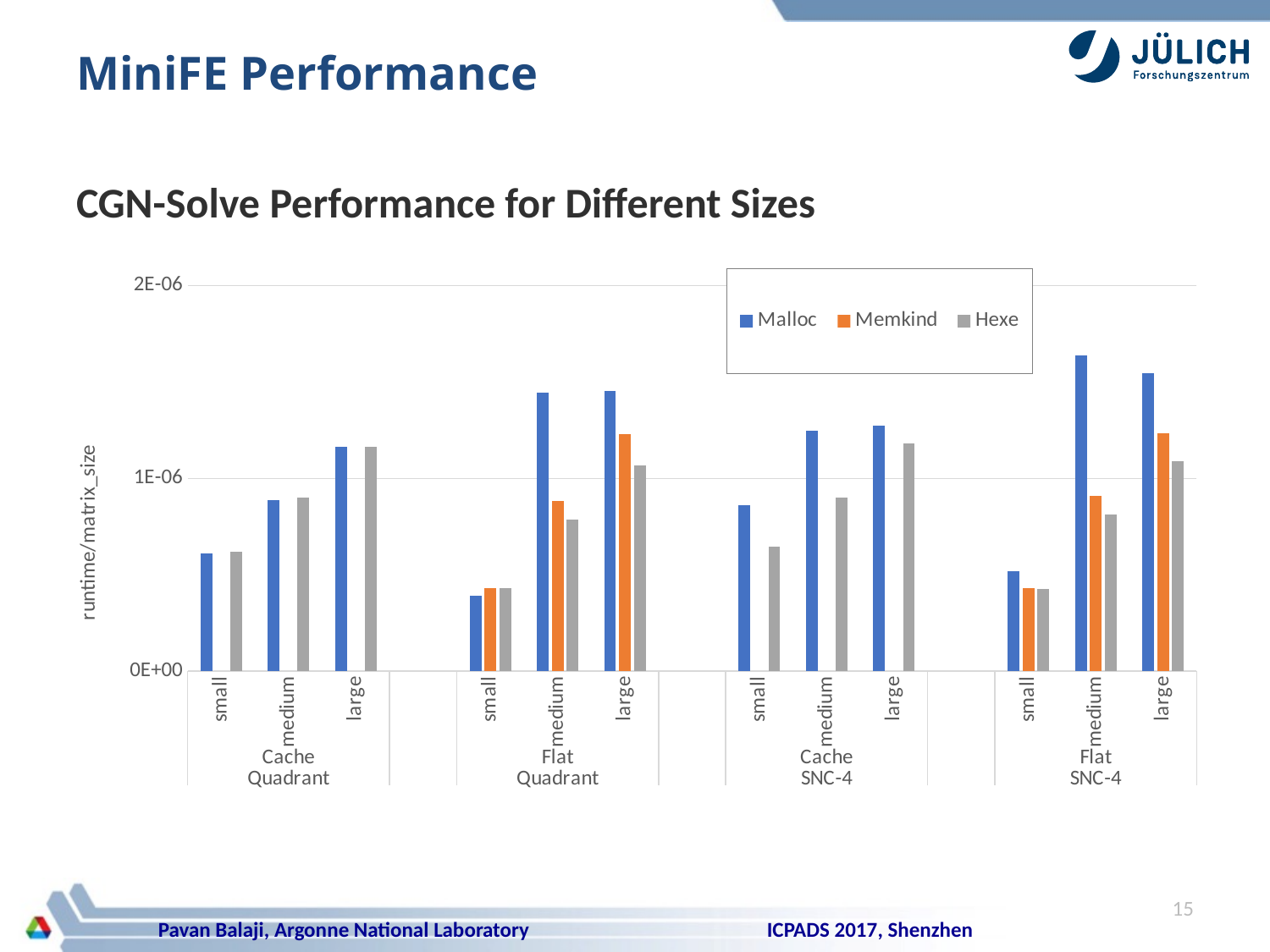
What kind of chart is shown on the slide? bar chart Is the Malloc value for Cache Quadrant small greater or less than 1E-06? less How many memory configurations (groups) are shown along the x axis? 4 What is the label on the vertical axis? runtime/matrix_size Is the Malloc value for Flat Quadrant large greater or less than 1E-06? greater Which series has the highest value for Flat SNC-4 medium? Malloc Is the Hexe value for Flat SNC-4 small greater or less than 1E-06? less Which series are listed in the legend? Malloc, Memkind, Hexe For Flat Quadrant medium, which is larger: Malloc or Hexe? Malloc Do the Malloc values for Cache Quadrant rise or fall from small to large? rise How many series does the legend list? 3